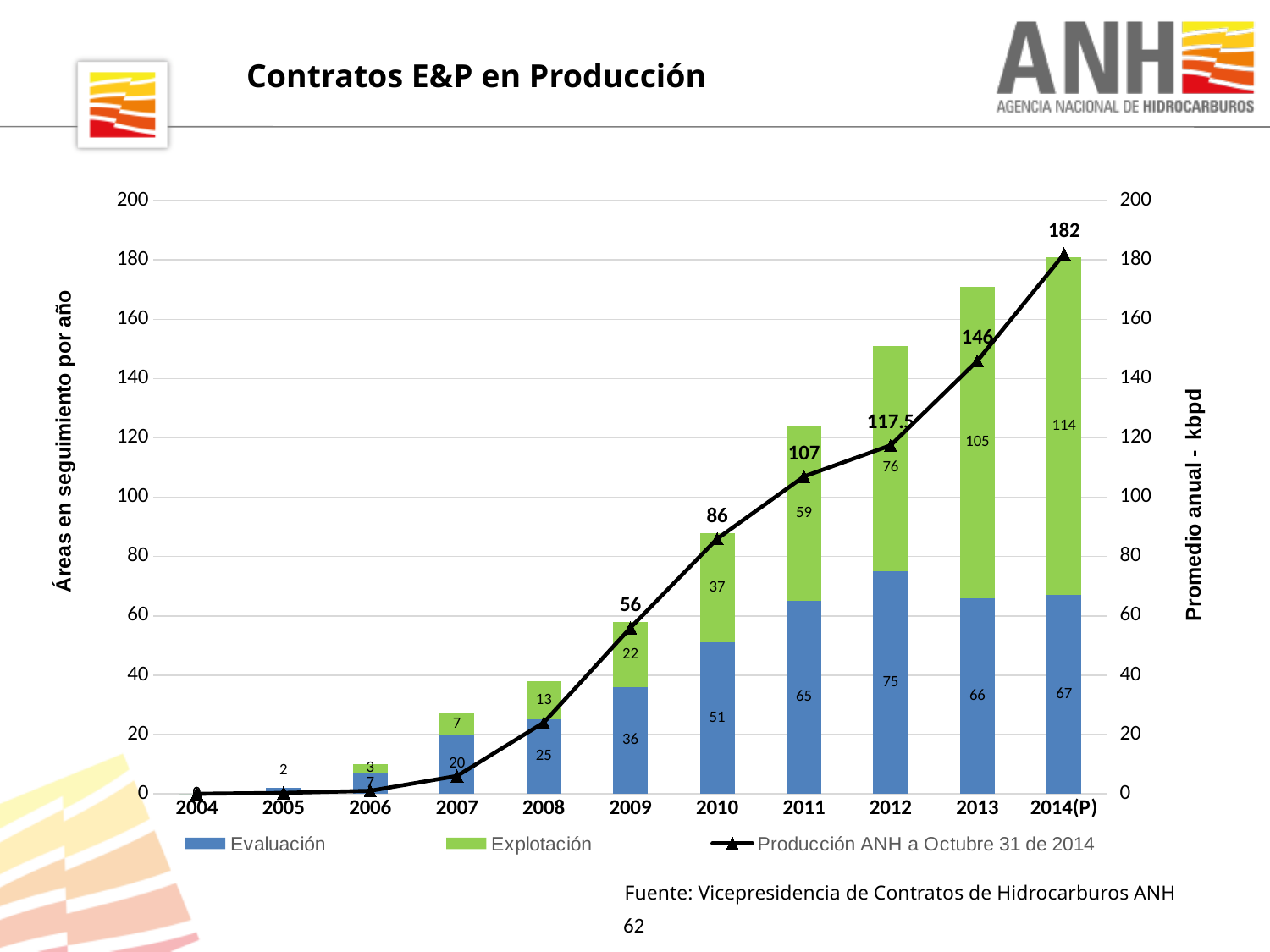
What is the difference between the Explotación values for 2014(P) and 2013? 9 In which year is the Explotación value highest? 2014(P) What is the Explotación value for 2014(P)? 114 In which year is the Evaluación value highest? 2012 How many series does the legend list? 3 How many years are shown on the x axis? 11 What is the total of the stacked bar for 2014(P)? 181 For 2011, which is larger, Evaluación or Explotación? Evaluación What is the Evaluación value for 2012? 75 What is the value of the Producción ANH a Octubre 31 de 2014 line for 2013? 146 Does the Producción ANH a Octubre 31 de 2014 line rise or fall from 2009 to 2014(P)? rise What is the value of the Producción ANH a Octubre 31 de 2014 line for 2012? 117.5